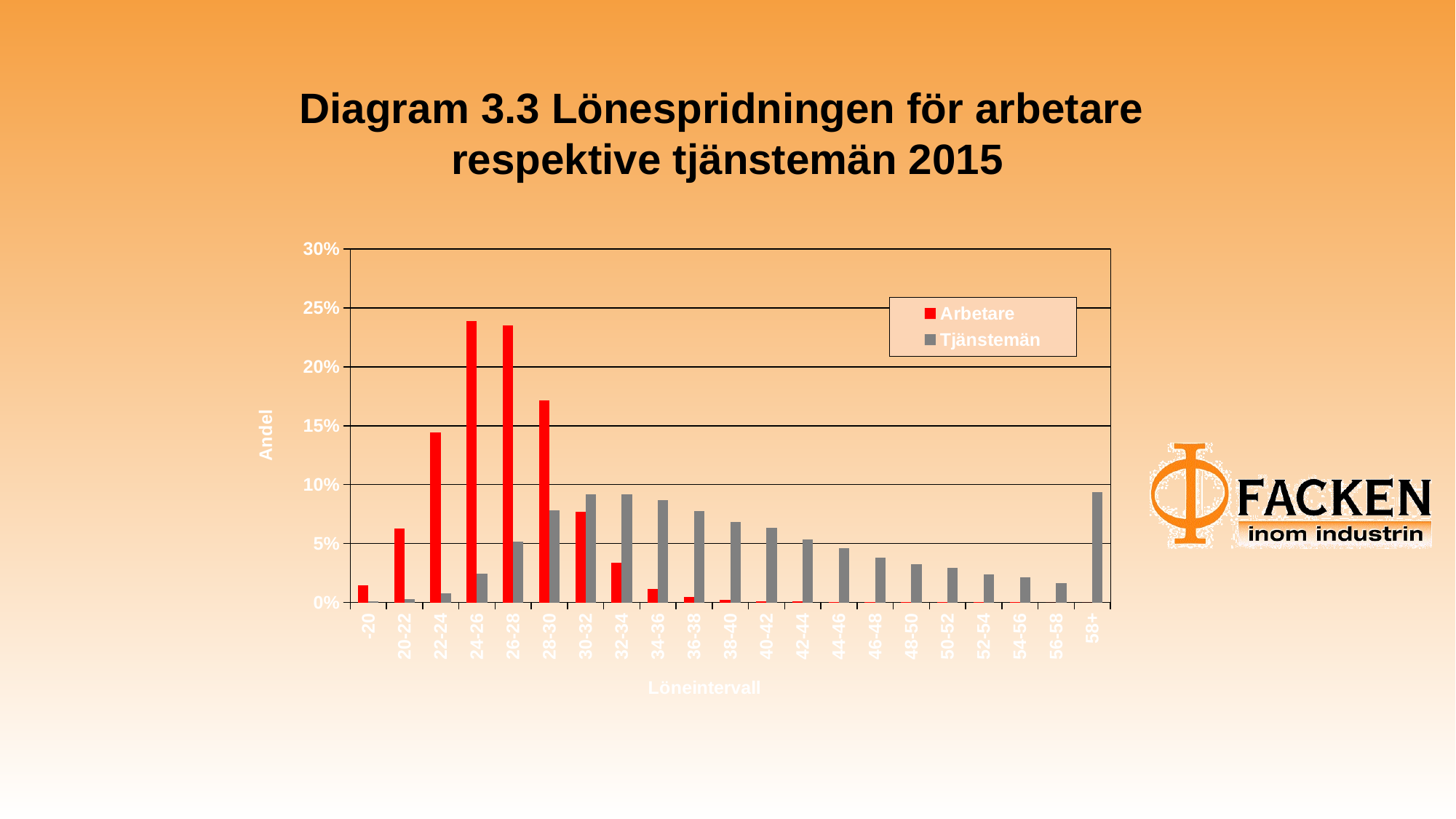
How many salary interval categories are shown on the x axis? 21 What is the title of the x axis? Löneintervall Is the Arbetare value for 22-24 greater or less than 15%? less Is the Arbetare value for 28-30 greater or less than 15%? greater For the 24-26 interval, which series has the larger value, Arbetare or Tjänstemän? Arbetare Is the Tjänstemän value for 34-36 greater or less than 5%? greater What kind of chart is shown on the slide? bar chart For the 34-36 interval, which series has the larger value, Arbetare or Tjänstemän? Tjänstemän How many series does the legend list? 2 Do the Tjänstemän values rise or fall from 34-36 to 56-58? fall